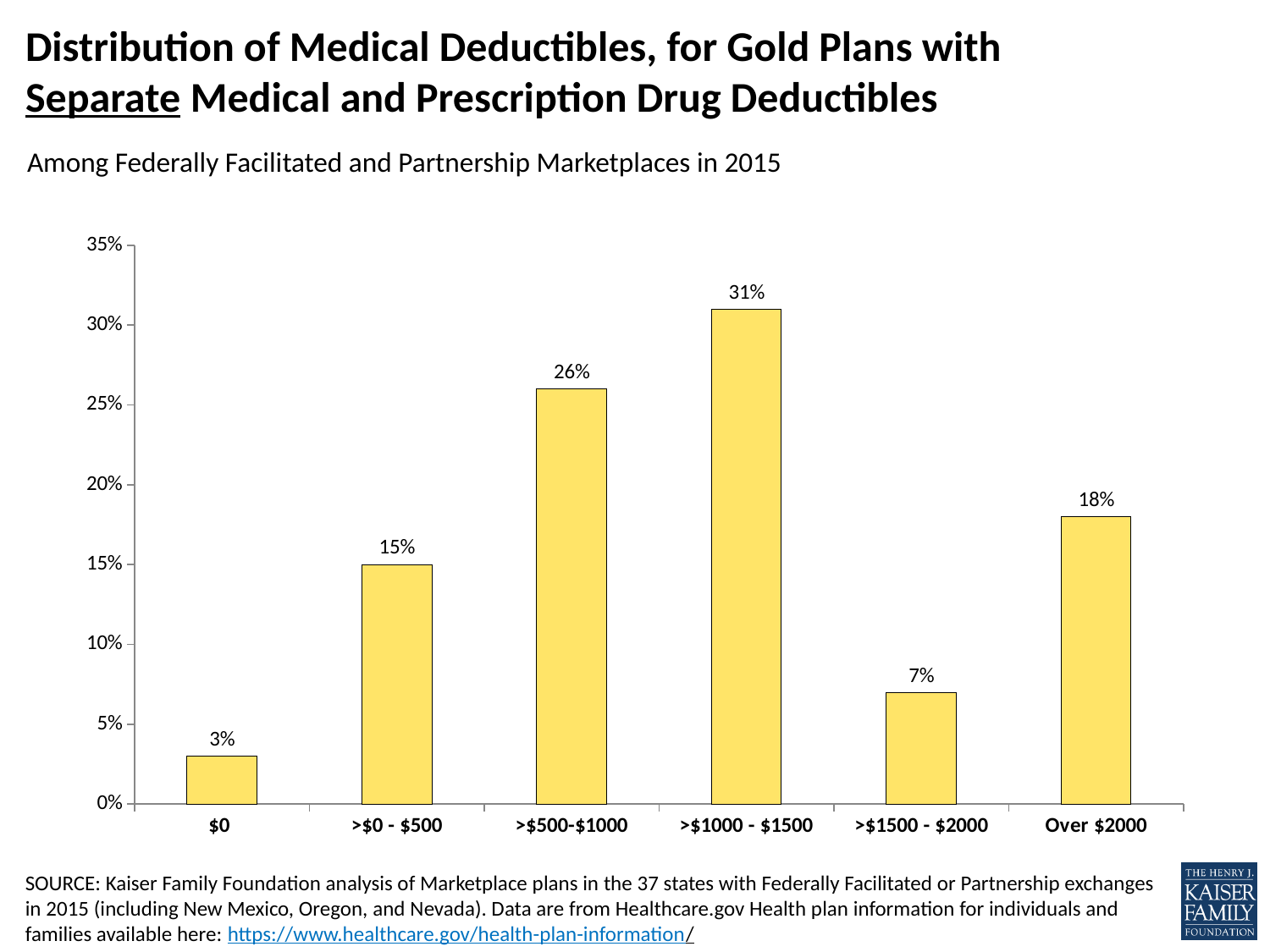
What share of plans have a medical deductible over $2000? 18% Is the value for >$500-$1000 greater or less than 25%? greater Which deductible category has the highest percentage of plans? >$1000 - $1500 What percentage of gold plans have a medical deductible of $0? 3% Which deductible category has the lowest percentage of plans? $0 What is the difference in percentage points between the >$500-$1000 and >$1500 - $2000 categories? 19 How many deductible categories are shown on the x axis? 6 What is the value for the >$1500 - $2000 category? 7% What kind of chart is shown on the slide? Bar chart What is the highest value shown on the y axis? 35% What is the value for the >$1000 - $1500 deductible category? 31% Which is larger: the value for >$0 - $500 or the value for Over $2000? Over $2000